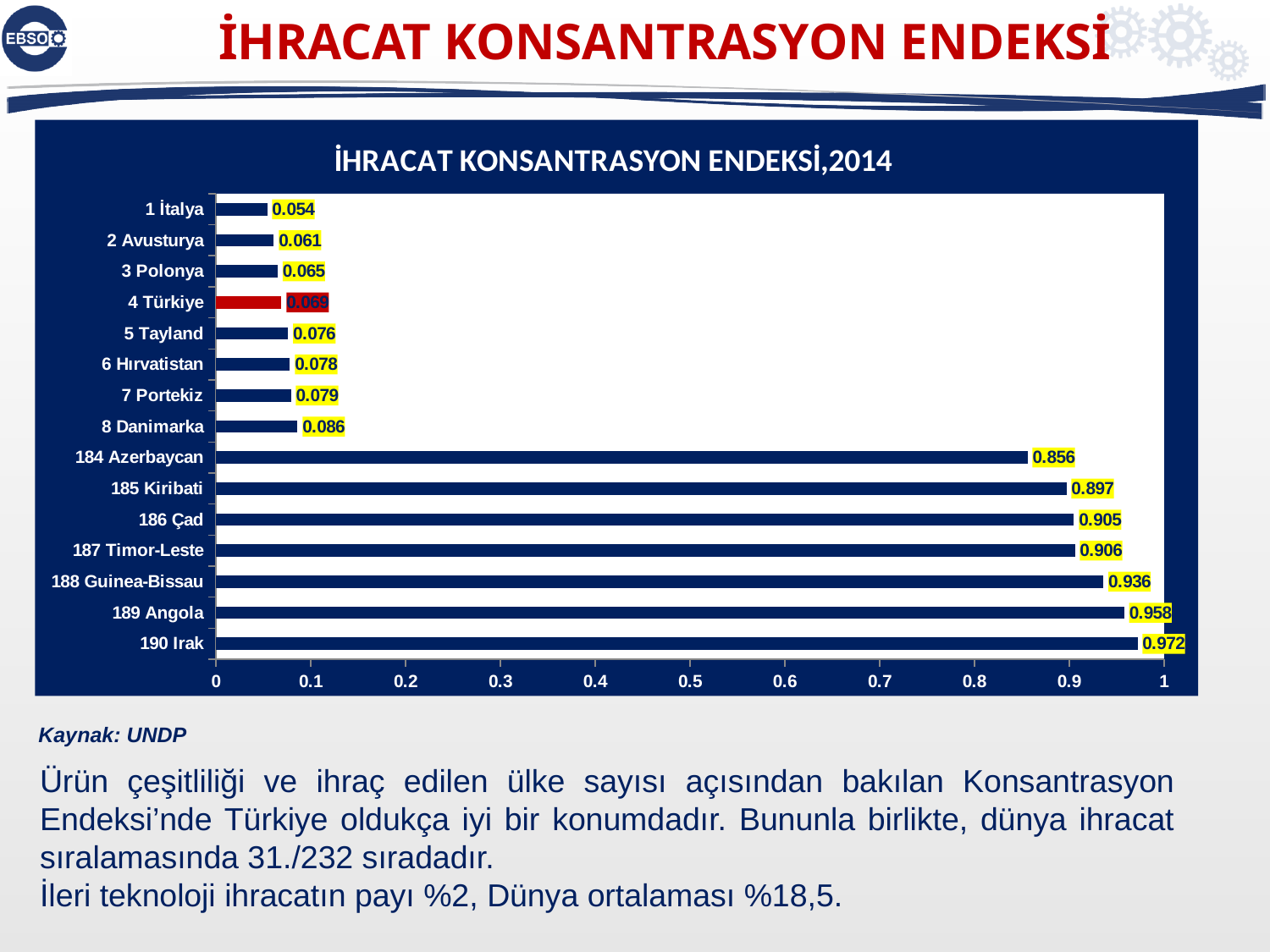
What is the title of the chart? İHRACAT KONSANTRASYON ENDEKSİ,2014 Which has a larger value, 185 Kiribati or 188 Guinea-Bissau? 188 Guinea-Bissau What is the value shown for 190 Irak? 0.972 What is the difference between the values for 8 Danimarka and 1 İtalya? 0.032 What is the value shown for 184 Azerbaycan? 0.856 Which country has the lowest value on the chart? 1 İtalya What kind of chart is shown on the slide? Bar chart How many countries are shown on the chart? 15 Which country has the highest value on the chart? 190 Irak What is the difference between the values for 190 Irak and 189 Angola? 0.014 What is the export concentration index value for 4 Türkiye? 0.069 Is the value for 186 Çad greater or less than 0.9? greater